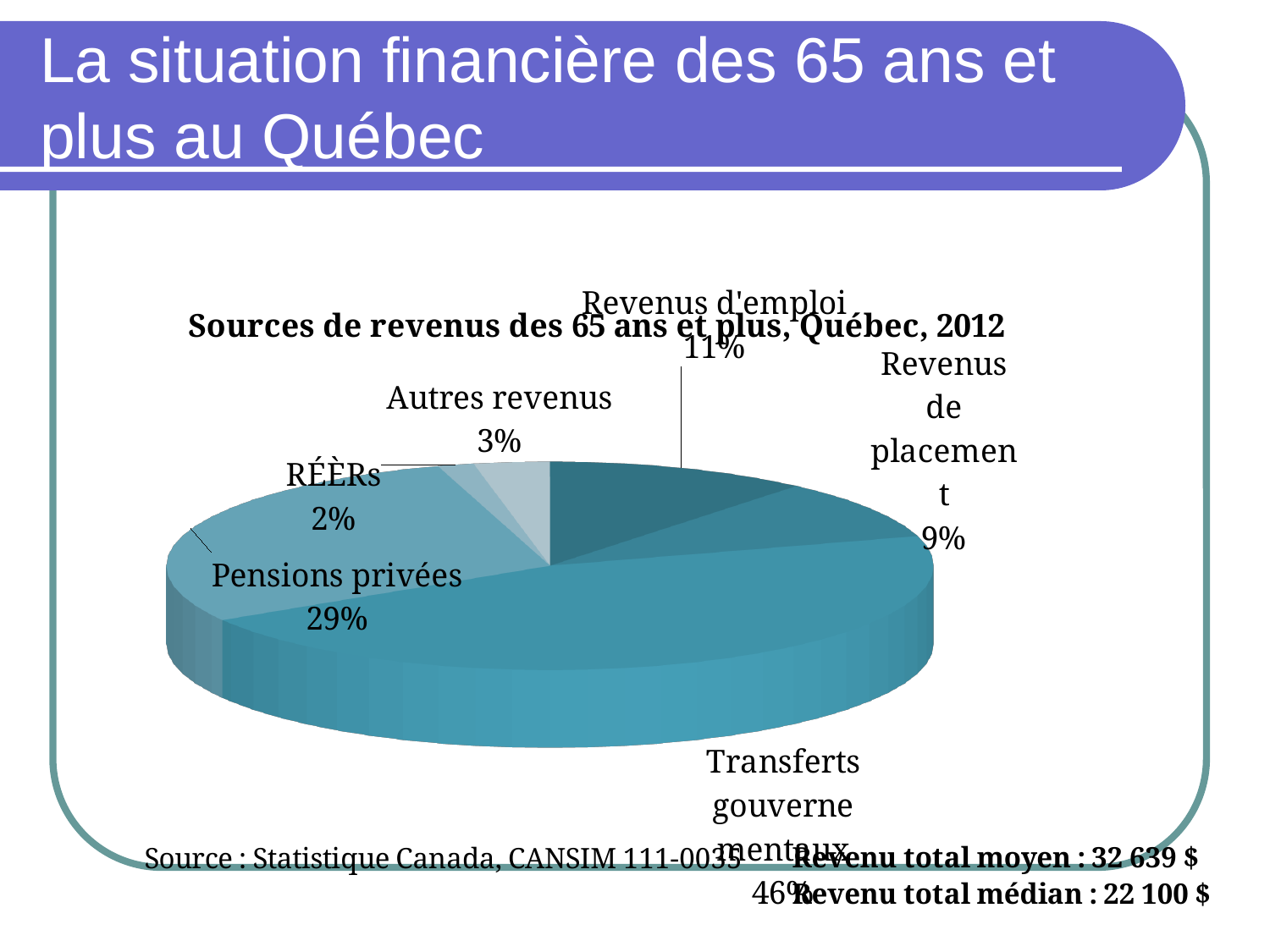
What is the value shown for Revenus de placement? 9% Which source of income has the largest share of the pie? Transferts gouvernementaux Which source of income has the smallest share of the pie? RÉÈRs Which is larger, Revenus d'emploi or Revenus de placement? Revenus d'emploi What is the difference in percentage points between Transferts gouvernementaux and Pensions privées? 17 How many slices does the pie chart have? 6 What is the value shown for Pensions privées? 29% What is the title of the pie chart? Sources de revenus des 65 ans et plus, Québec, 2012 What is the value shown for RÉÈRs? 2% What is the value shown for Revenus d'emploi? 11% What share of the pie does Transferts gouvernementaux represent? 46% What kind of chart is shown on the slide? Pie chart